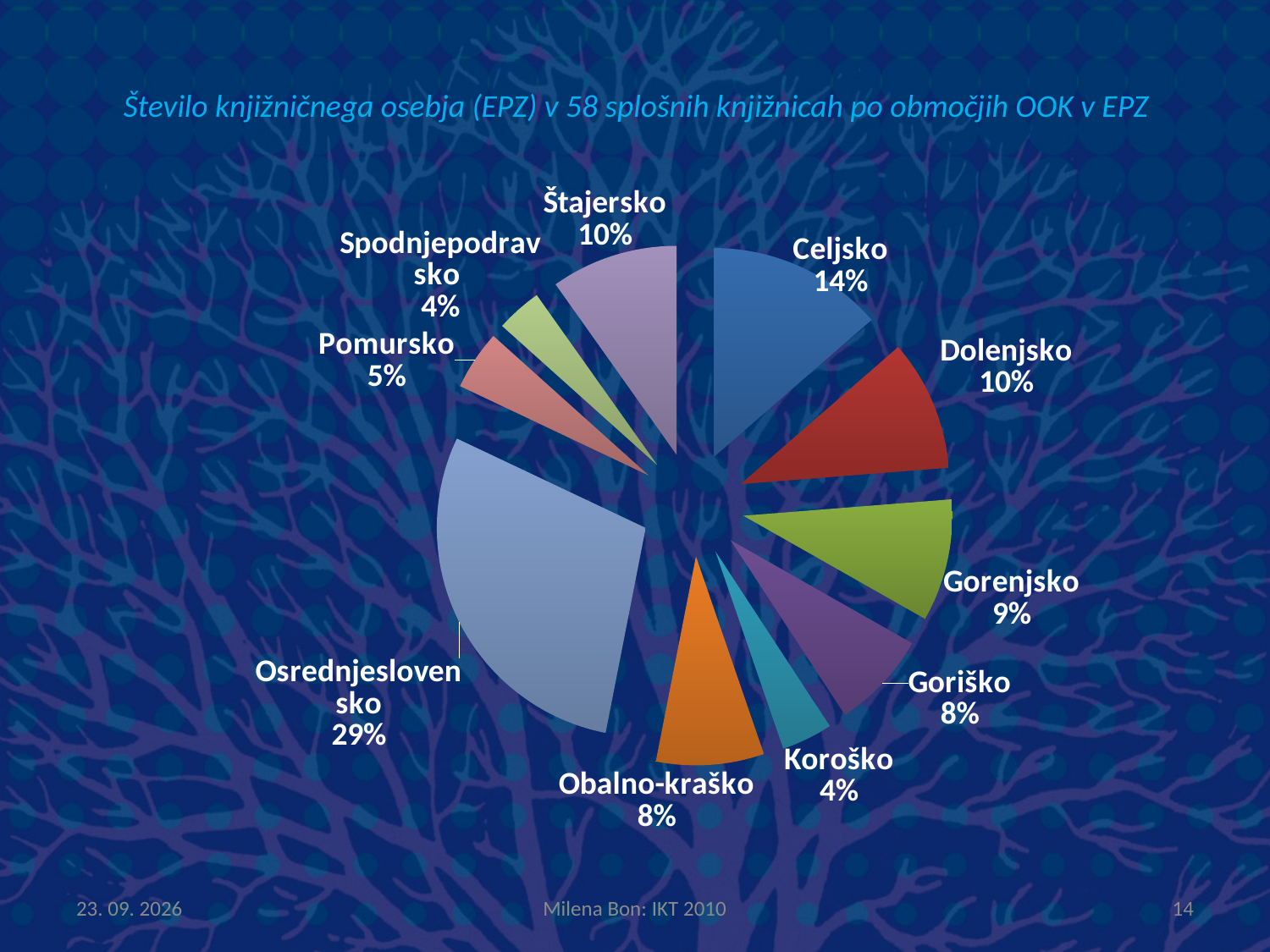
What is the difference in percentage points between Štajersko and Koroško? 6 What percentage is shown for Obalno-kraško? 8% Which region has the largest slice of the pie? Osrednjeslovensko What type of chart is shown on the slide? pie chart Which is larger, the share for Dolenjsko or the share for Goriško? Dolenjsko How many slices does the pie chart have? 10 What is the difference in percentage points between Osrednjeslovensko and Celjsko? 15 What share of the pie does Celjsko have? 14% What percentage is shown for Gorenjsko? 9% What percentage is shown for Pomursko? 5% What share of the pie does Osrednjeslovensko have? 29% What is the title of the chart? Število knjižničnega osebja (EPZ) v 58 splošnih knjižnicah po območjih OOK v EPZ